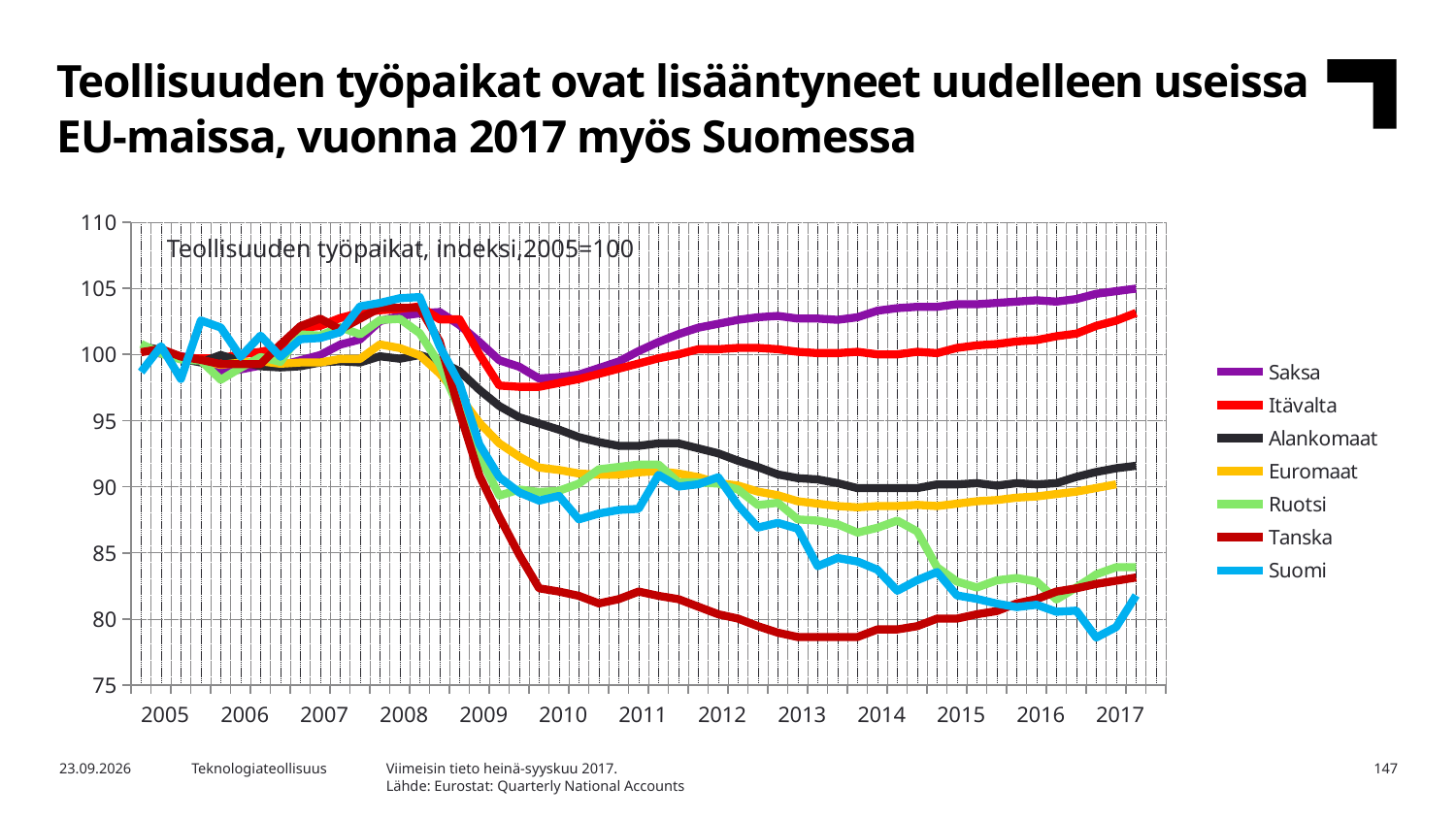
In 2016, which is larger: the value for Alankomaat or the value for Suomi? Alankomaat How many series does the legend list? 7 Is the value for Suomi in 2017 greater or less than 85? less What is the title printed inside the chart area? Teollisuuden työpaikat, indeksi,2005=100 Is the value for Alankomaat in 2017 greater or less than 90? greater Which series is shown in purple in the legend? Saksa Is the value for Tanska in 2013 greater or less than 80? less Does the Tanska line rise or fall between 2008 and 2013? fall What kind of chart is shown on the slide? line chart Which series has the lowest value in 2013? Tanska Which series has the highest value in 2017? Saksa